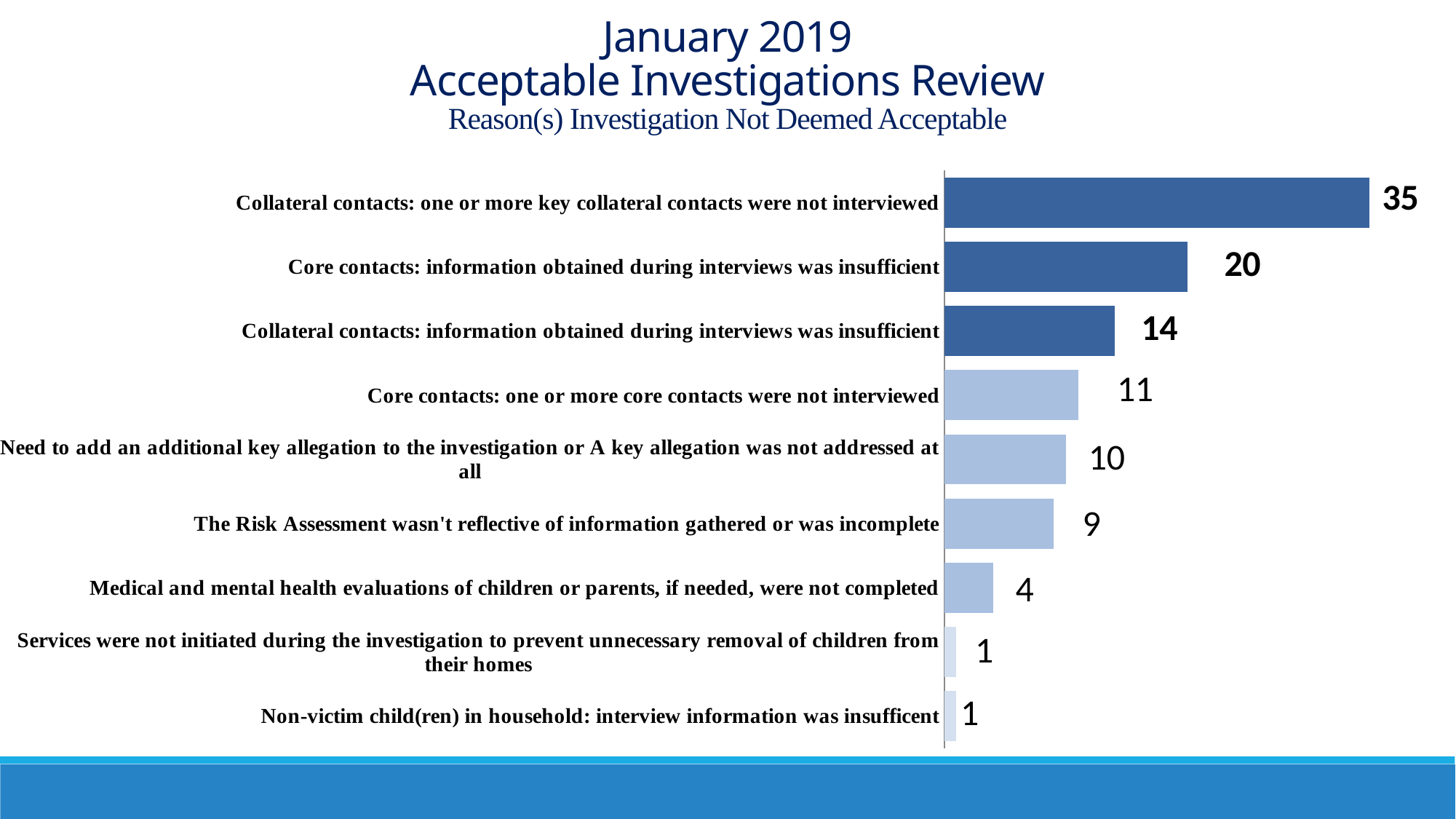
Which is larger: the value for "Core contacts: one or more core contacts were not interviewed" or the value for "Need to add an additional key allegation to the investigation or A key allegation was not addressed at all"? Core contacts: one or more core contacts were not interviewed What kind of chart is shown on the slide? Bar chart What is the value for "Medical and mental health evaluations of children or parents, if needed, were not completed"? 4 What is the value for "The Risk Assessment wasn't reflective of information gathered or was incomplete"? 9 How many reasons (categories) are shown in the chart? 9 What is the value for "Collateral contacts: one or more key collateral contacts were not interviewed"? 35 What is the difference between the values for "Collateral contacts: information obtained during interviews was insufficient" and "Core contacts: one or more core contacts were not interviewed"? 3 What is the subtitle of the chart shown on the slide? Reason(s) Investigation Not Deemed Acceptable What is the value for "Non-victim child(ren) in household: interview information was insufficent"? 1 What is the value for "Core contacts: information obtained during interviews was insufficient"? 20 Which reason has the highest value? Collateral contacts: one or more key collateral contacts were not interviewed What is the difference between the values for "Collateral contacts: one or more key collateral contacts were not interviewed" and "Core contacts: information obtained during interviews was insufficient"? 15